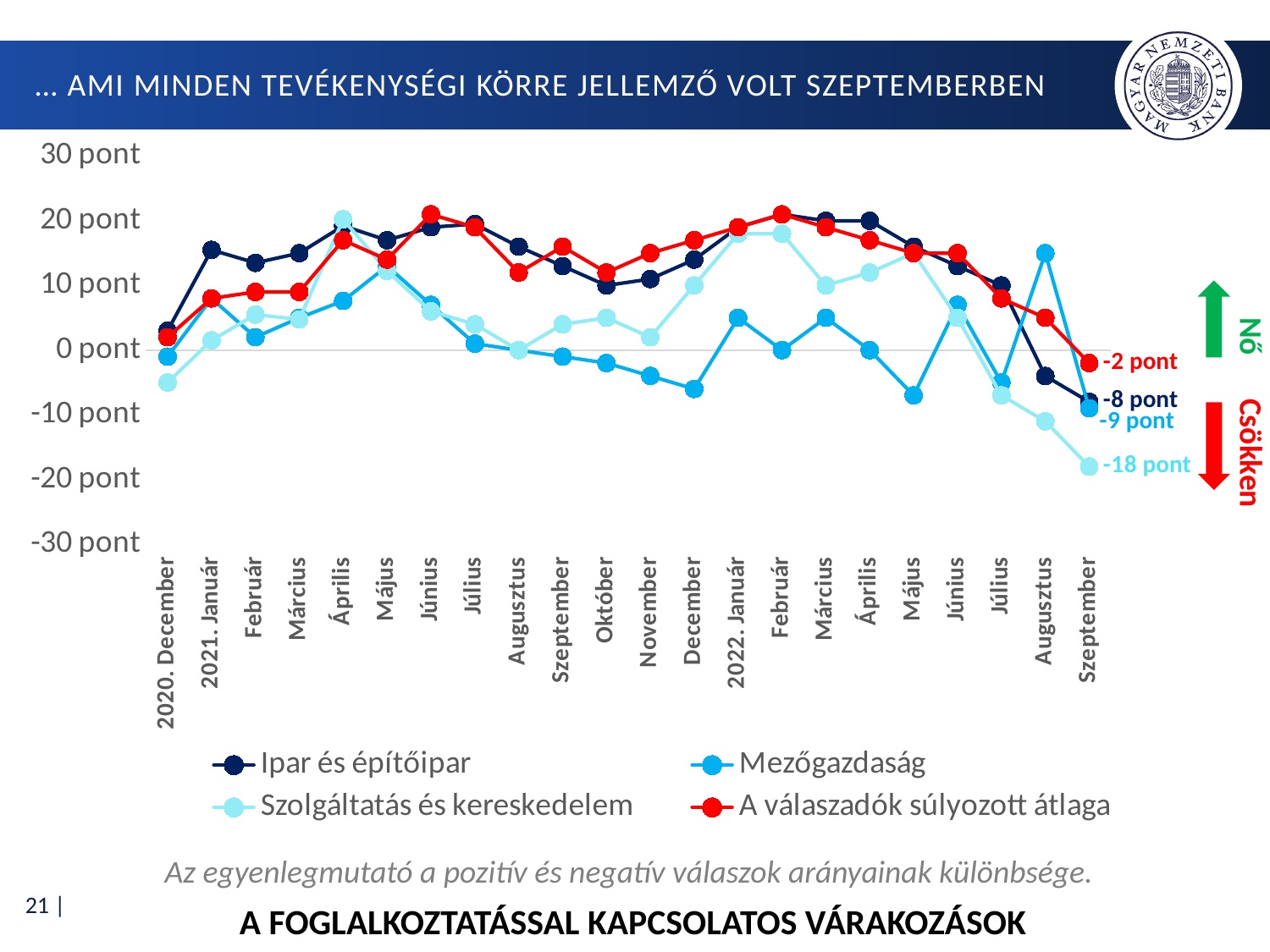
What is the value for Szolgáltatás és kereskedelem in Szeptember 2022? -18 pont Which series has the lowest value in Szeptember 2022? Szolgáltatás és kereskedelem Which series has the highest value in Szeptember 2022? A válaszadók súlyozott átlaga Is the value for Szolgáltatás és kereskedelem in 2020. December greater or less than 0 pont? less How many series does the legend list? 4 What kind of chart is shown on the slide? line chart In Szeptember 2022, which is higher: Ipar és építőipar or Mezőgazdaság? Ipar és építőipar Is the value for Mezőgazdaság in Augusztus 2022 greater or less than 10 pont? greater What is the value for A válaszadók súlyozott átlaga in Szeptember 2022? -2 pont What is the value for Ipar és építőipar in Szeptember 2022? -8 pont What is the difference between the Ipar és építőipar and Szolgáltatás és kereskedelem values in Szeptember 2022? 10 pont Does the A válaszadók súlyozott átlaga series rise or fall from Február 2022 to Szeptember 2022? fall